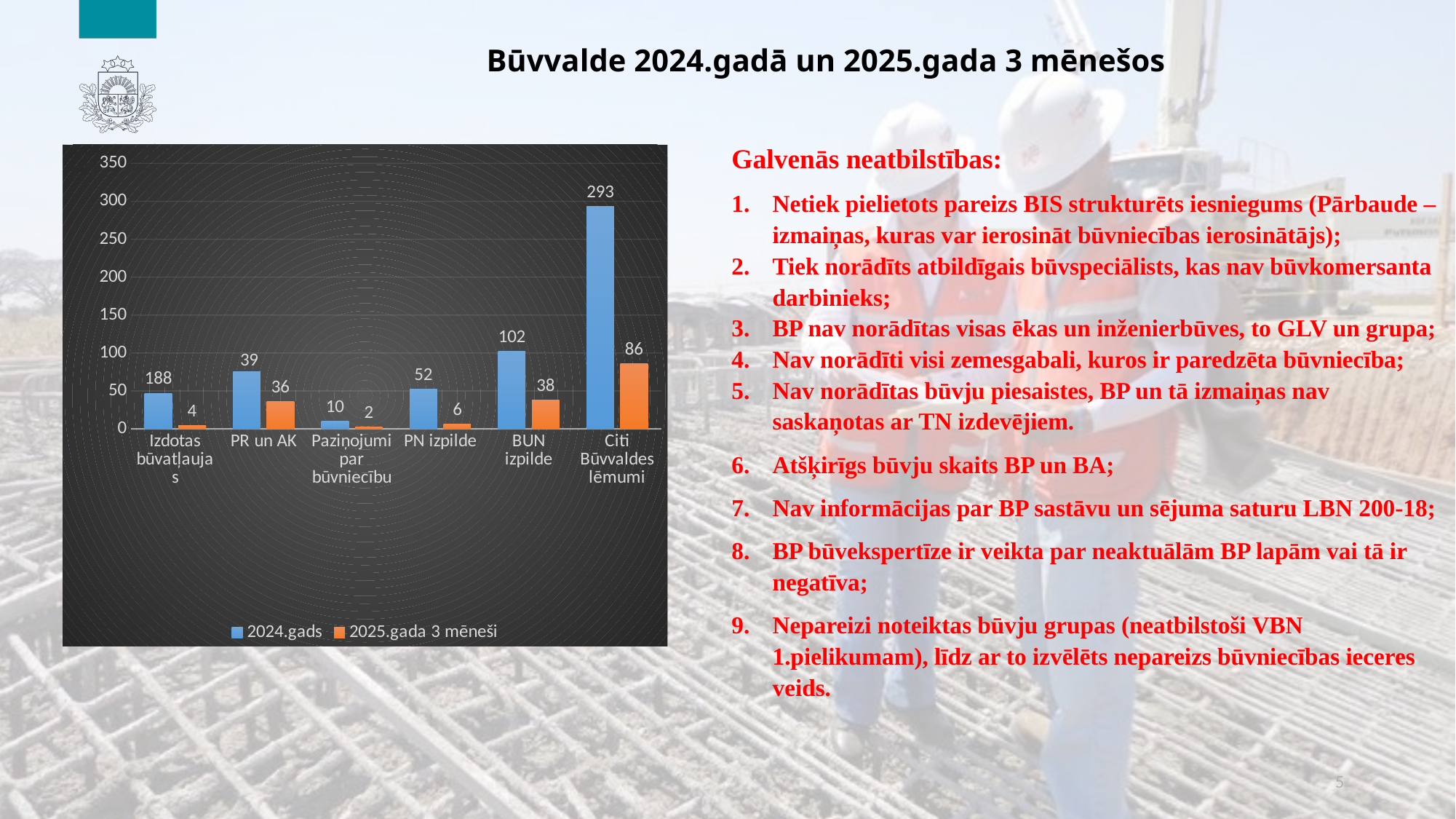
What is the difference between the 2024.gads and 2025.gada 3 mēneši values for Citi Būvvaldes lēmumi? 207 What is the value for BUN izpilde in the 2024.gads series? 102 What is the value for PN izpilde in the 2025.gada 3 mēneši series? 6 What is the value for Citi Būvvaldes lēmumi in the 2025.gada 3 mēneši series? 86 What kind of chart is shown on the slide? Bar chart Which is larger in the 2025.gada 3 mēneši series: BUN izpilde or PR un AK? BUN izpilde Which category has the lowest value in the 2025.gada 3 mēneši series? Paziņojumi par būvniecību What is the difference between the 2024.gads and 2025.gada 3 mēneši values for BUN izpilde? 64 How many categories are shown on the x axis of the chart? 6 Which category has the highest value in the 2024.gads series? Citi Būvvaldes lēmumi How many series does the chart legend list? 2